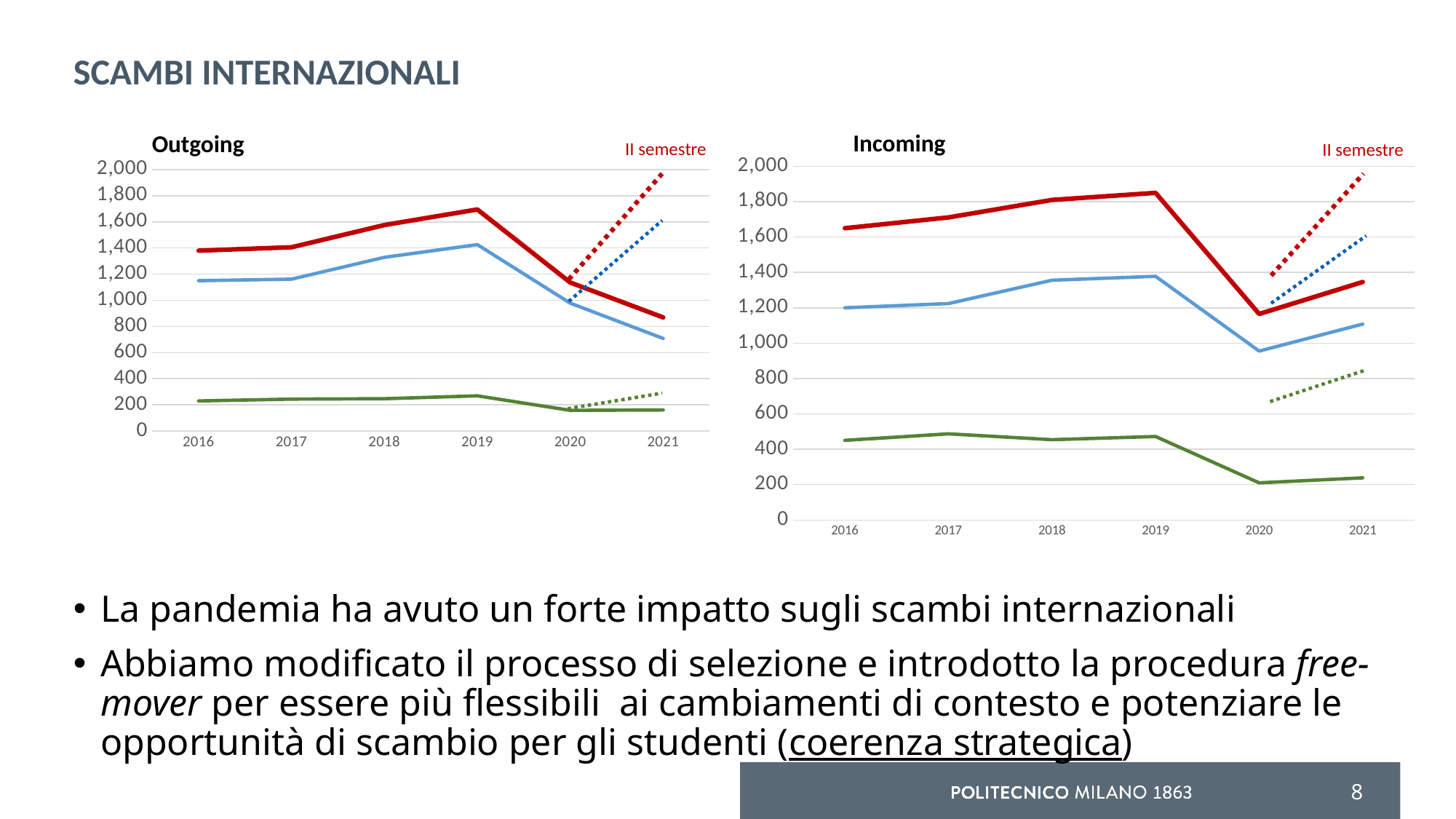
In the Incoming chart, in which year does the blue line reach its lowest value? 2020 In the Outgoing chart, is the value of the blue line in 2021 greater or less than 800? less In the Outgoing chart, how many years are shown on the x axis? 6 What label is given to the dotted lines in both charts? II semestre In the Outgoing chart, is the value of the red line in 2019 greater or less than 1,600? greater In the Incoming chart, does the red line rise or fall from 2016 to 2019? rise In the Incoming chart, is the value of the green line in 2020 greater or less than 400? less In the Incoming chart, is the red line higher in 2020 or in 2021? 2021 In the Outgoing chart, does the red line rise or fall from 2019 to 2021? fall What kind of chart is the Outgoing chart? line chart In the Outgoing chart, in which year does the red line reach its highest value? 2019